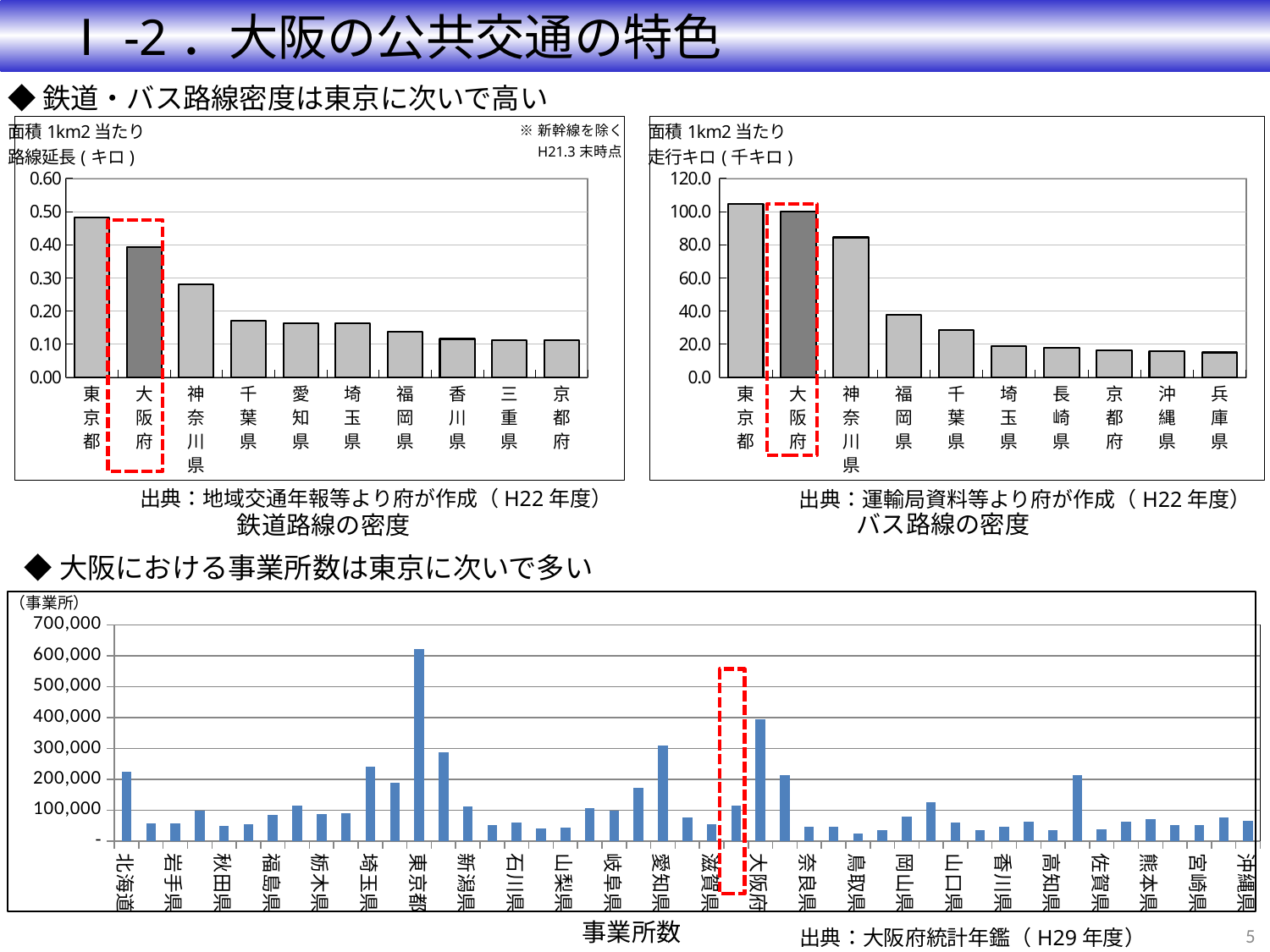
In the 鉄道路線の密度 chart, is the value for 大阪府 greater or less than 0.30? greater In the 鉄道路線の密度 chart, which prefecture has the highest value? 東京都 In the 鉄道路線の密度 chart, how many prefectures are shown on the x axis? 10 In the 事業所数 chart, is the value for 大阪府 greater or less than 300,000? greater What kind of chart is the 鉄道路線の密度 chart? bar chart In the 鉄道路線の密度 chart, is the value for 神奈川県 greater or less than 0.30? less In the 鉄道路線の密度 chart, do the values rise or fall from left to right along the x axis? fall In the バス路線の密度 chart, how many prefectures are shown on the x axis? 10 In the バス路線の密度 chart, which is larger, the value for 神奈川県 or the value for 福岡県? 神奈川県 In the 事業所数 chart, which prefecture has the highest value? 東京都